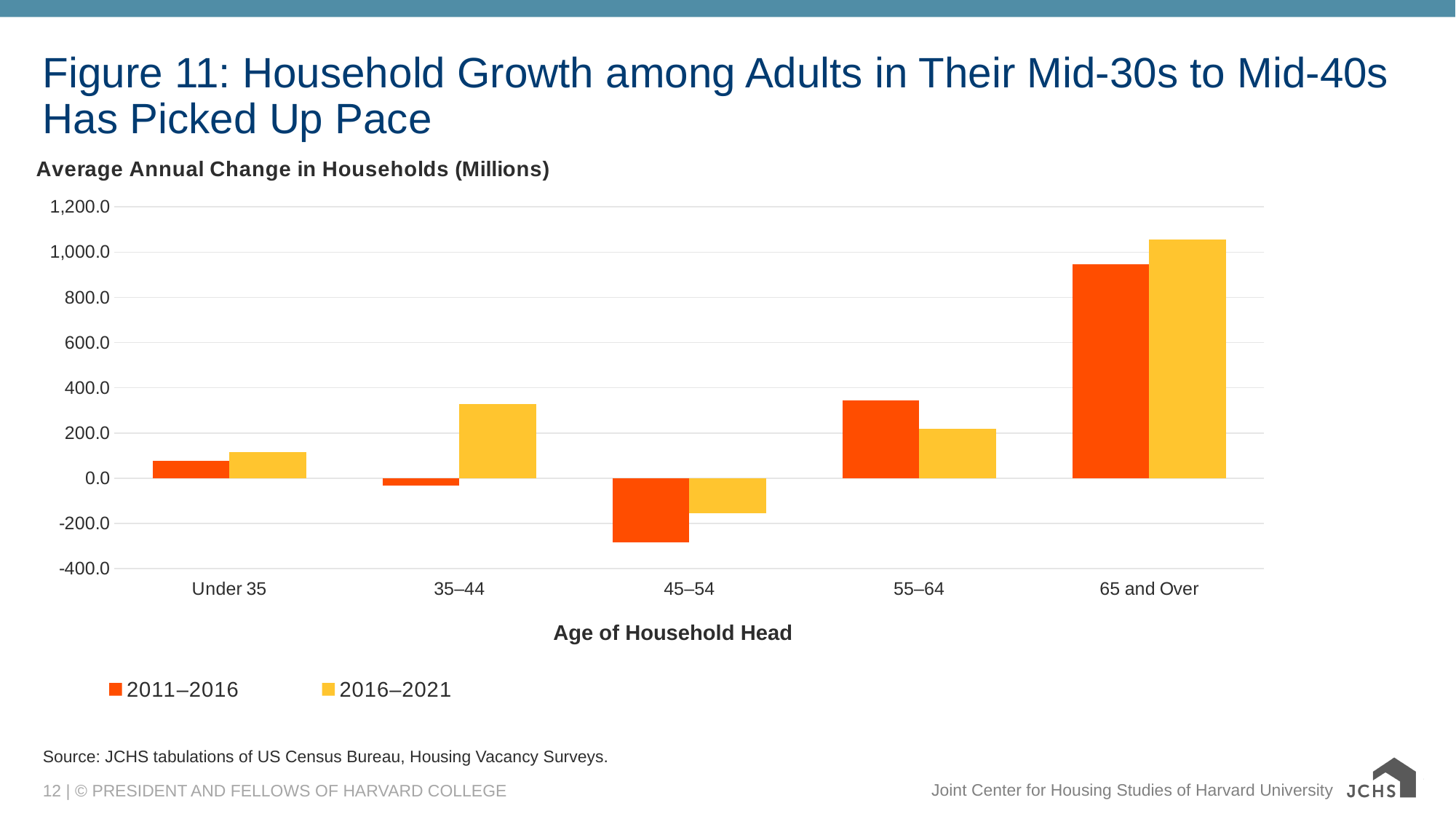
Which age group has the highest value for 2016–2021? 65 and Over How many series does the legend list? 2 Is the 2011–2016 value for 55–64 greater or less than 200.0? greater Is the 2016–2021 value for 65 and Over greater or less than 1,000.0? greater Which age group has the lowest value for 2011–2016? 45–54 Is the 2011–2016 value for 45–54 greater or less than -200.0? less How many age categories are shown on the x axis? 5 What kind of chart is shown on the slide? bar chart For the 55–64 age group, which series has the larger value, 2011–2016 or 2016–2021? 2011–2016 Which age group has the highest value across both series? 65 and Over What is the title of the x axis? Age of Household Head For the 35–44 age group, which series has the larger value, 2011–2016 or 2016–2021? 2016–2021